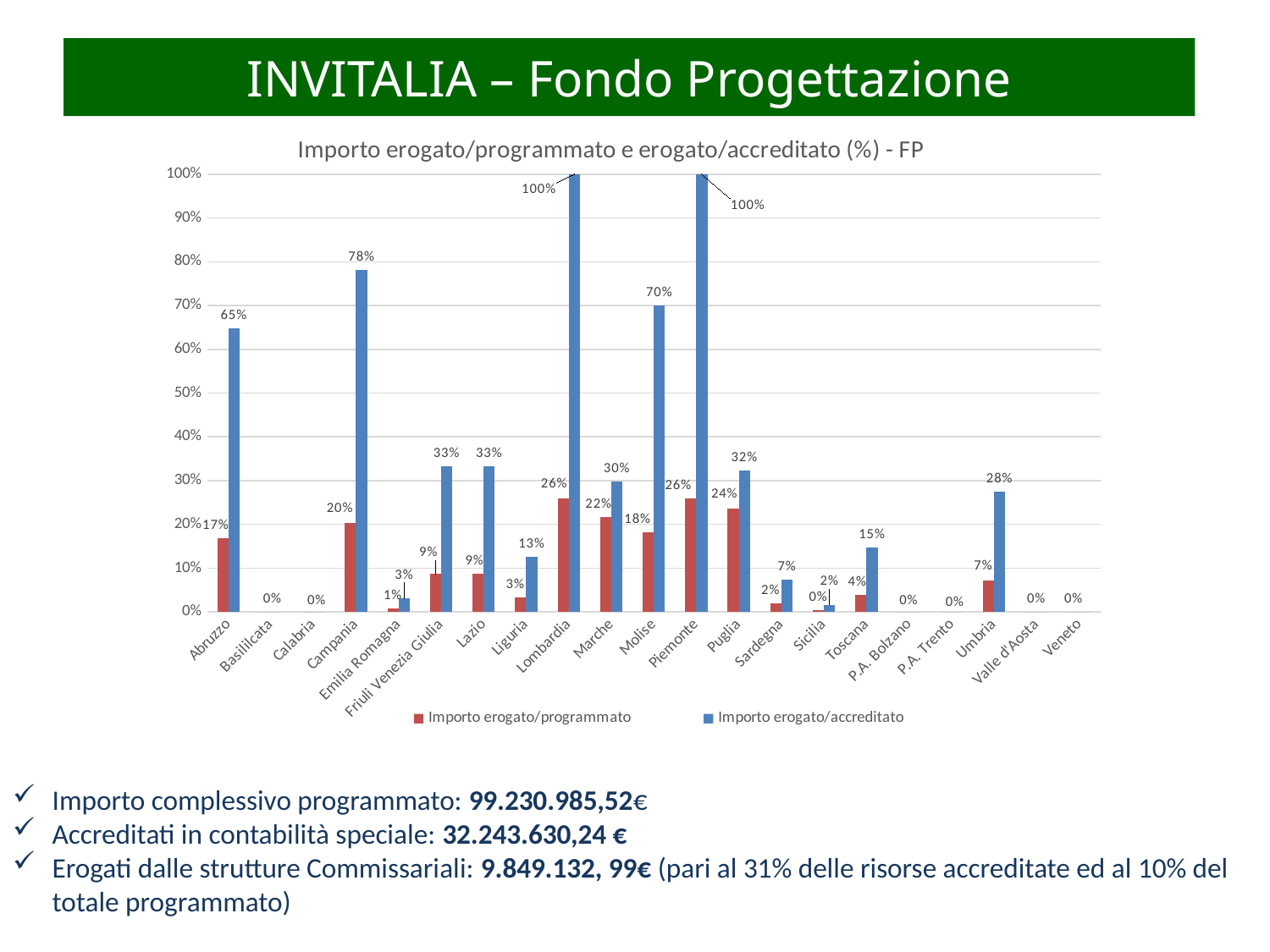
What is the title of the chart? Importo erogato/programmato e erogato/accreditato (%) - FP How many regions are shown on the x axis of the chart? 21 What is the difference between Importo erogato/accreditato and Importo erogato/programmato for Abruzzo? 48% How many series does the legend list? 2 What is the value of Importo erogato/accreditato for Molise? 70% What is the difference between Importo erogato/accreditato and Importo erogato/programmato for Campania? 58% What kind of chart is shown on the slide? bar chart What is the value of Importo erogato/accreditato for Toscana? 15% Which region has the higher Importo erogato/accreditato, Umbria or Toscana? Umbria What is the value of Importo erogato/accreditato for Umbria? 28% What is the value of Importo erogato/programmato for Abruzzo? 17% What is the value of Importo erogato/accreditato for Campania? 78%